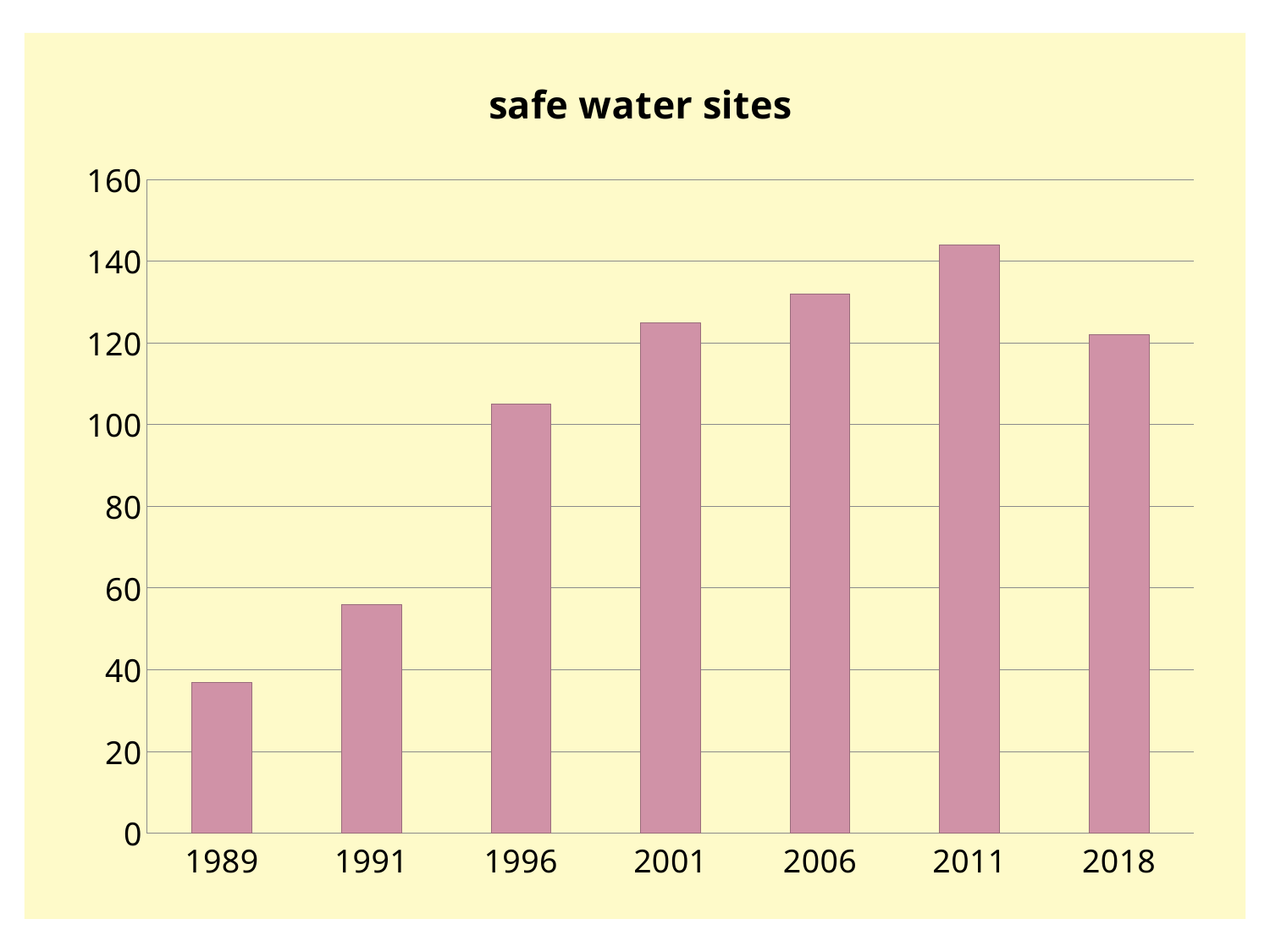
Is the value for 2011 greater or less than 140? greater Is the value for 1996 greater or less than 100? greater How many years are shown on the x axis of the chart? 7 Is the value for 1989 greater or less than 40? less What kind of chart is shown on the slide? bar chart What is the title of the chart? safe water sites Which year has the lowest value in the chart? 1989 Which year has the highest value in the chart? 2011 Which is larger, the value for 2011 or the value for 2018? 2011 Do the values rise or fall from 1989 to 2011? rise